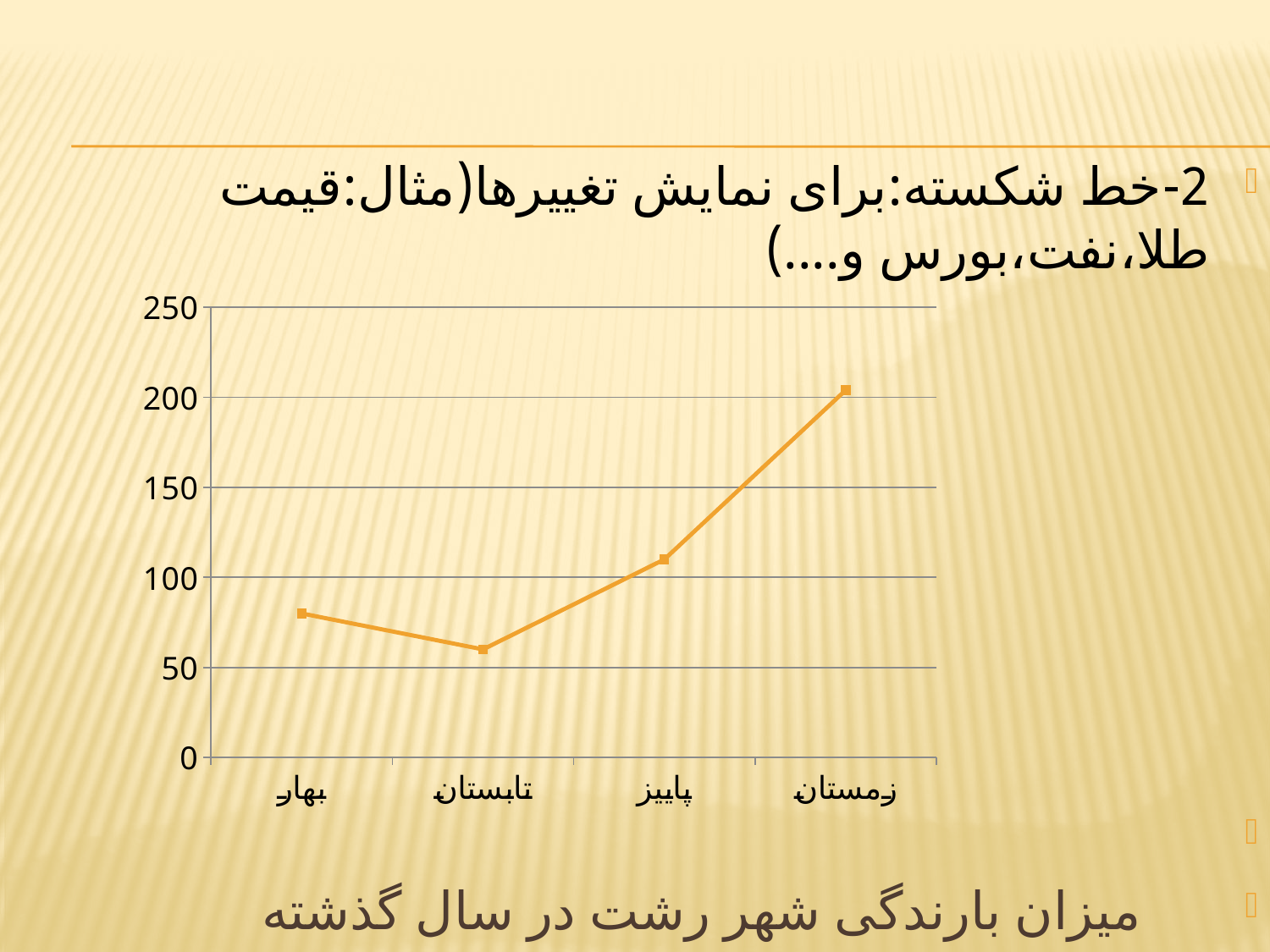
Which category has the lowest value in the chart? تابستان Which category has the highest value in the chart? زمستان Which is larger, the value for بهار or the value for تابستان? بهار Which is larger, the value for پاییز or the value for بهار? پاییز What is the caption written below the chart? میزان بارندگی شهر رشت در سال گذشته Is the value for پاییز greater or less than 150? less Is the value for زمستان greater or less than 150? greater What kind of chart is shown on the slide? line chart Is the value for تابستان greater or less than 100? less How many categories are plotted along the x axis of the chart? 4 Do the values rise or fall from تابستان to زمستان? rise